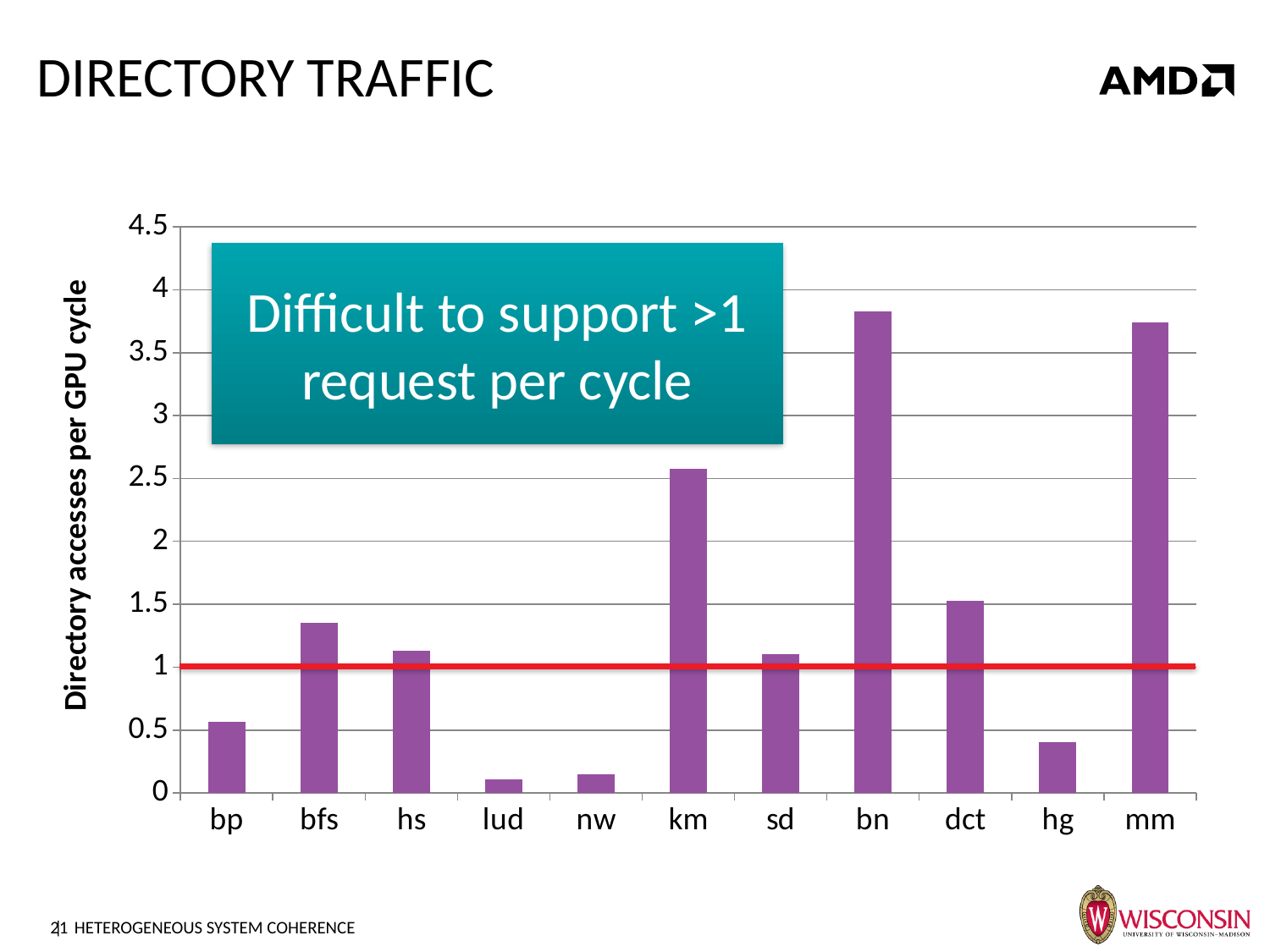
Is the value for km greater or less than 2? greater How many categories are shown on the x axis of the chart? 11 Is the value for bn greater or less than 3.5? greater At what y-axis value is the horizontal red line drawn? 1 What is the label of the y axis? Directory accesses per GPU cycle Is the value for bp greater or less than 1? less Which has a larger value, km or bfs? km What kind of chart is shown on the slide? bar chart Which has a larger value, hg or dct? dct